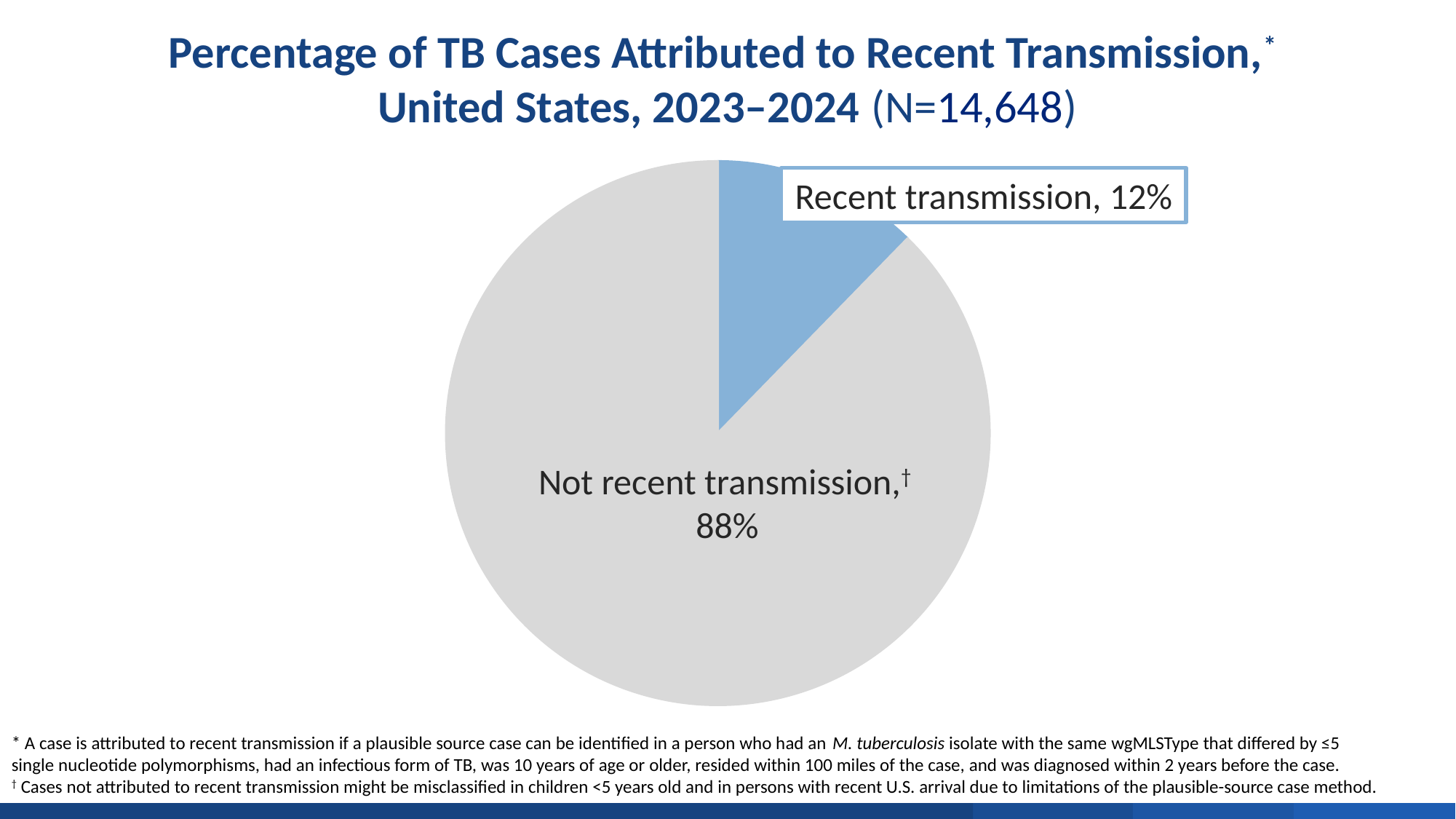
What is the difference in percentage points between not recent transmission and recent transmission? 76 What percentage of TB cases is attributed to not recent transmission? 88% What share of the pie does the recent transmission slice represent? 12% How many slices does the pie chart have? 2 What is the total number of cases (N) given in the chart title? 14,648 What percentage of TB cases is attributed to recent transmission? 12% Which is larger, the share for recent transmission or the share for not recent transmission? Not recent transmission Which slice of the pie is the largest? Not recent transmission Which slice of the pie is the smallest? Recent transmission What kind of chart is shown on the slide? Pie chart What colour is the recent transmission slice? Blue